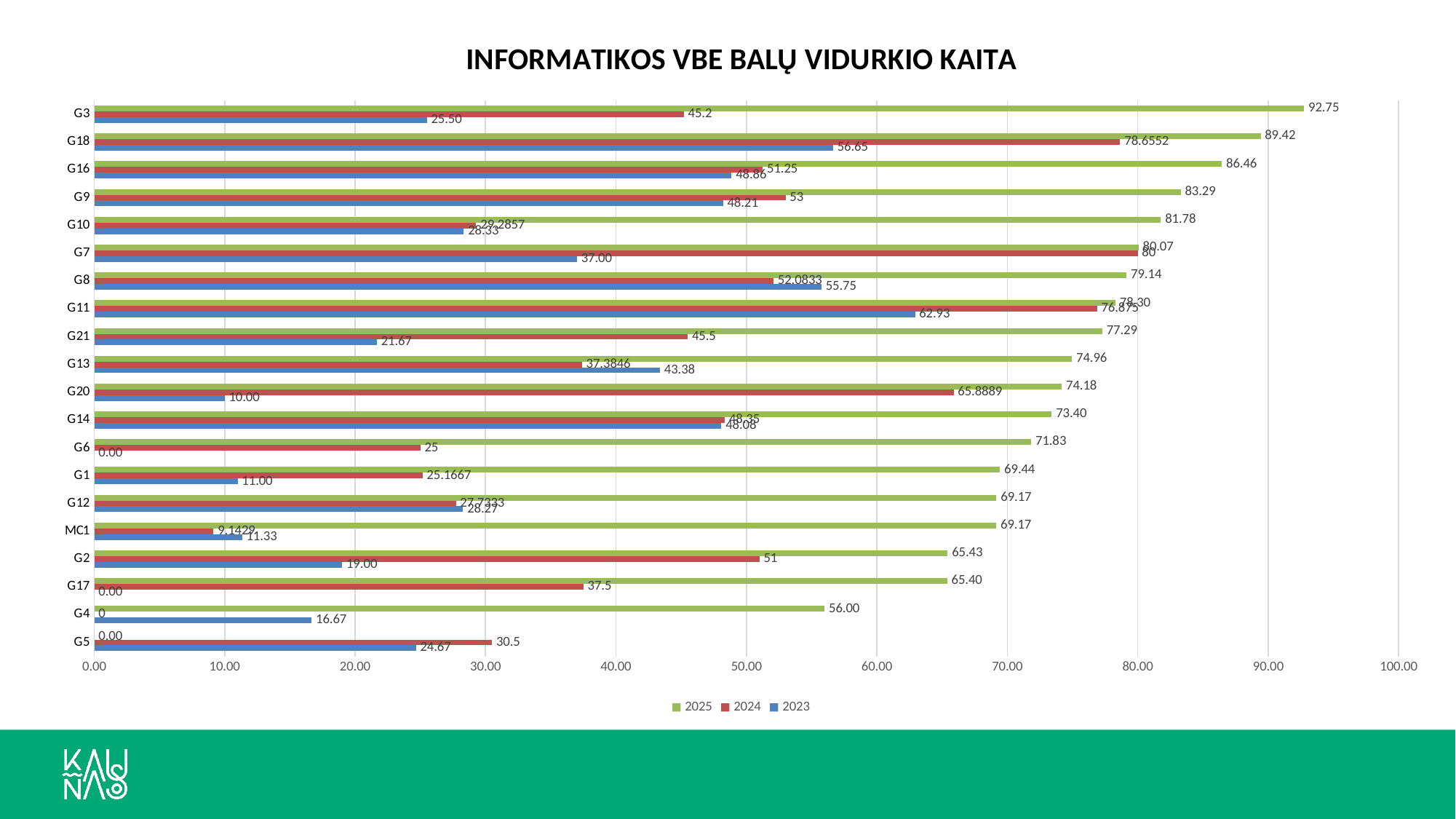
What is the title of the chart? INFORMATIKOS VBE BALŲ VIDURKIO KAITA What is the 2023 value for G18? 56.65 Which category has the highest 2025 value? G3 What is the difference between the 2025 and 2024 values for G3? 47.55 What kind of chart is shown on the slide? bar chart What is the 2024 value for G20? 65.8889 What is the 2025 value for G3? 92.75 What is the 2023 value for G20? 10.00 For G8, which is larger: the 2023 value or the 2024 value? 2023 How many series does the legend list? 3 Which category has the lowest 2025 value? G5 How many categories are plotted on the chart? 20